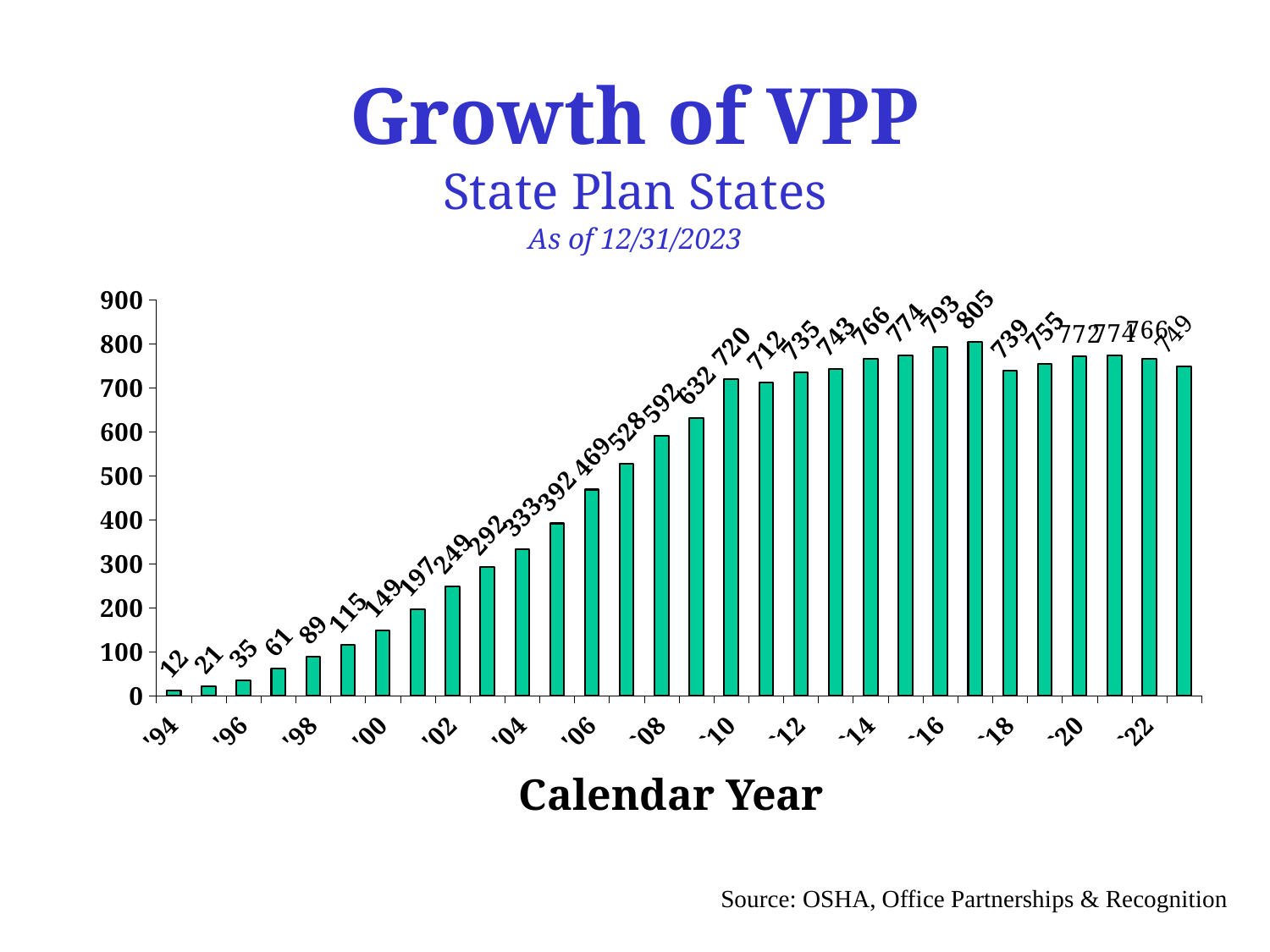
How many bars are plotted on the chart? 30 What is the highest value shown on the chart? 805 What is the value for '10 (2010)? 720 Which year has the lowest value? '94 Is the value for '04 greater or less than 300? greater What is the value for '06 (2006)? 469 What is the difference between the values for '10 and '00? 571 What is the value for '00 (2000)? 149 Do the values rise or fall from '94 to '10? rise What is the value for '98 (1998)? 89 Which is larger, the value for '08 or the value for '16? '16 What kind of chart is shown on the slide? bar chart